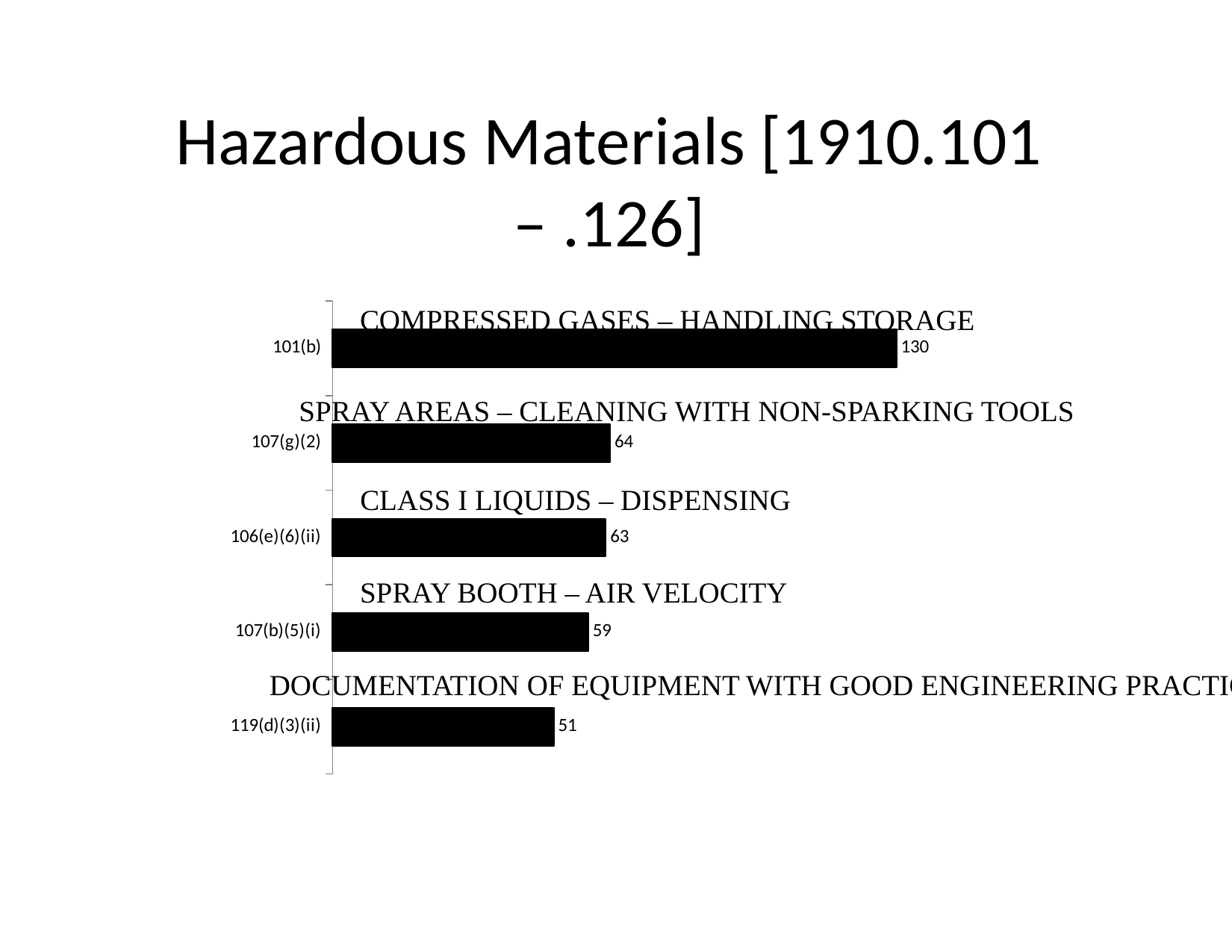
Which is larger, the value for 107(b)(5)(i) or the value for 119(d)(3)(ii)? 107(b)(5)(i) Which category has the highest value? 101(b) What is the value for 107(g)(2)? 64 What is the title of the slide? Hazardous Materials [1910.101 – .126] Which category has the lowest value? 119(d)(3)(ii) What is the difference between the values for 101(b) and 107(g)(2)? 66 How many categories are shown in the chart? 5 What is the value for 107(b)(5)(i)? 59 What is the value for 119(d)(3)(ii)? 51 What kind of chart is shown on the slide? Bar chart What is the value for 106(e)(6)(ii)? 63 What is the value for 101(b)? 130